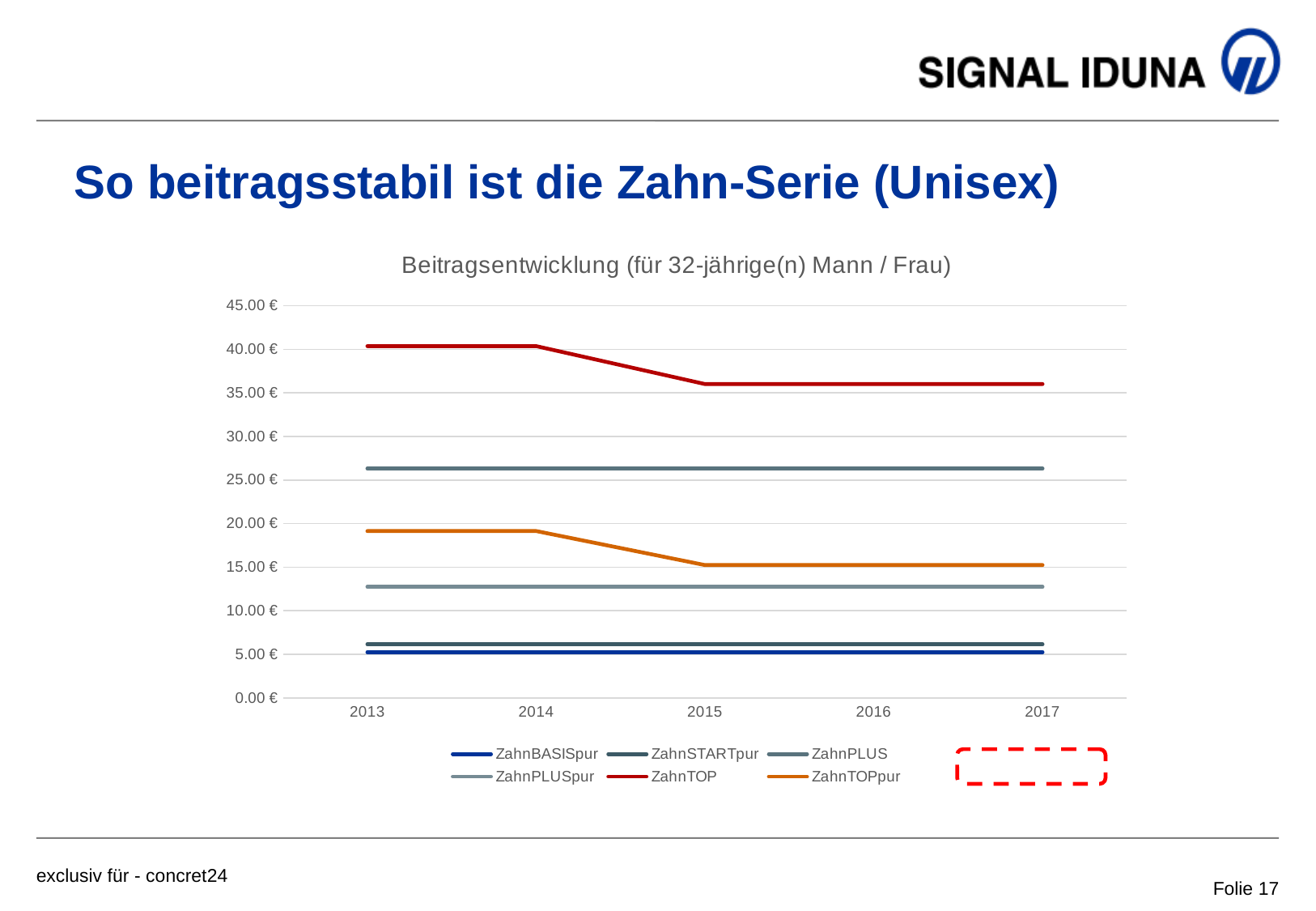
Which series has the lowest values across all years? ZahnBASISpur How many series does the legend list? 6 Which is larger in 2016, ZahnPLUS or ZahnTOPpur? ZahnPLUS Is the value for ZahnTOP in 2017 greater or less than 40.00 €? less Is the value for ZahnPLUSpur in 2015 greater or less than 15.00 €? less Does the value for ZahnTOP rise or fall from 2013 to 2017? fall Which series has the highest values across all years? ZahnTOP Is the value for ZahnTOPpur in 2017 greater or less than 20.00 €? less What kind of chart is shown on the slide? Line chart How many years are shown on the x axis? 5 What is the title of the chart? Beitragsentwicklung (für 32-jährige(n) Mann / Frau)